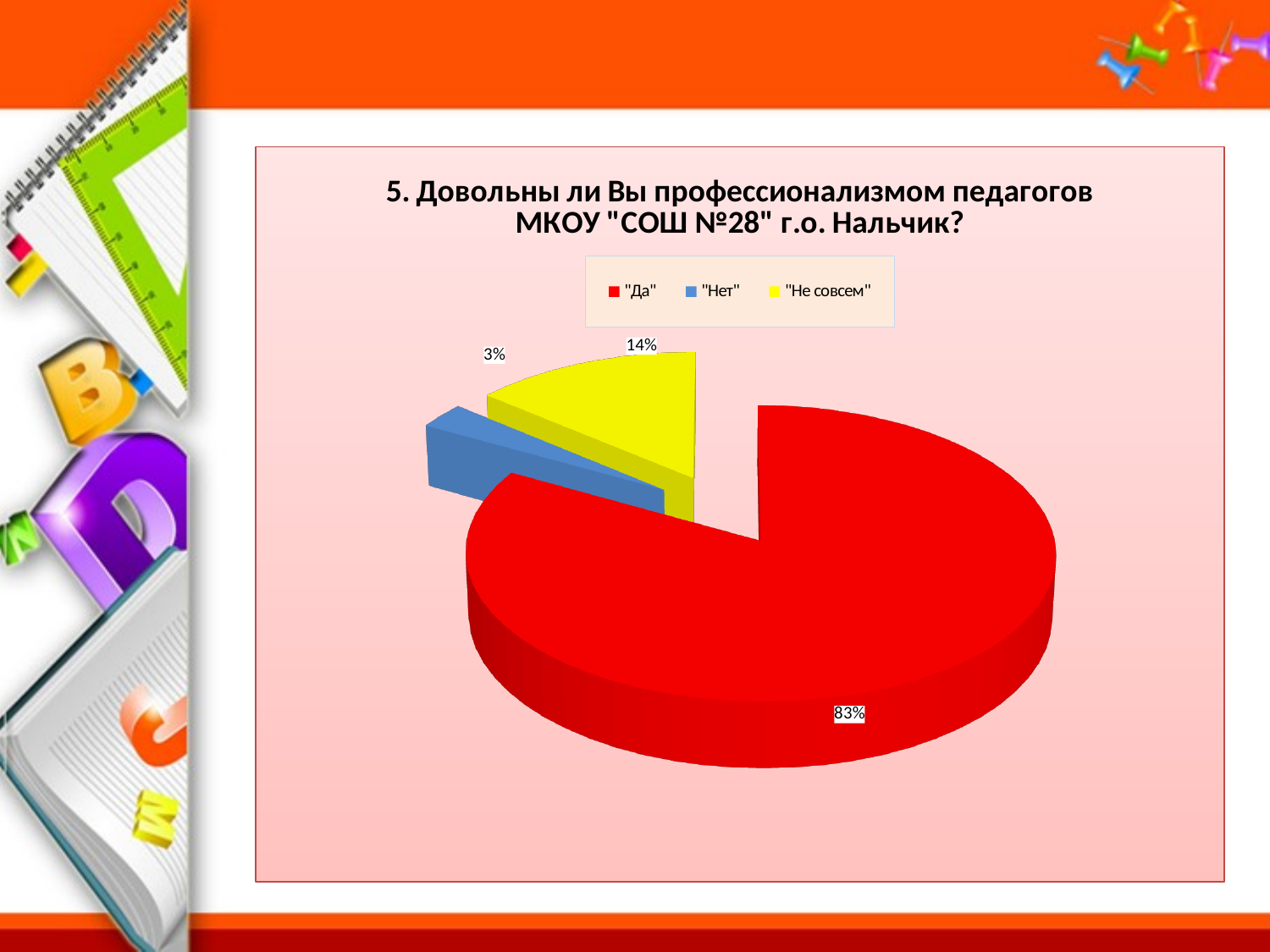
Which answer has the smallest share of the pie? "Нет" What colour is the slice for "Не совсем"? Yellow Which is larger, the share for "Нет" or the share for "Не совсем"? "Не совсем" What is the difference in percentage points between "Да" and "Не совсем"? 69 What share of respondents answered "Нет"? 3% What type of chart is shown on the slide? Pie chart How many slices does the pie chart have? 3 What share of respondents answered "Да"? 83% What is the difference in percentage points between "Не совсем" and "Нет"? 11 Which answer has the largest share of the pie? "Да" How many entries does the legend list? 3 What share of respondents answered "Не совсем"? 14%